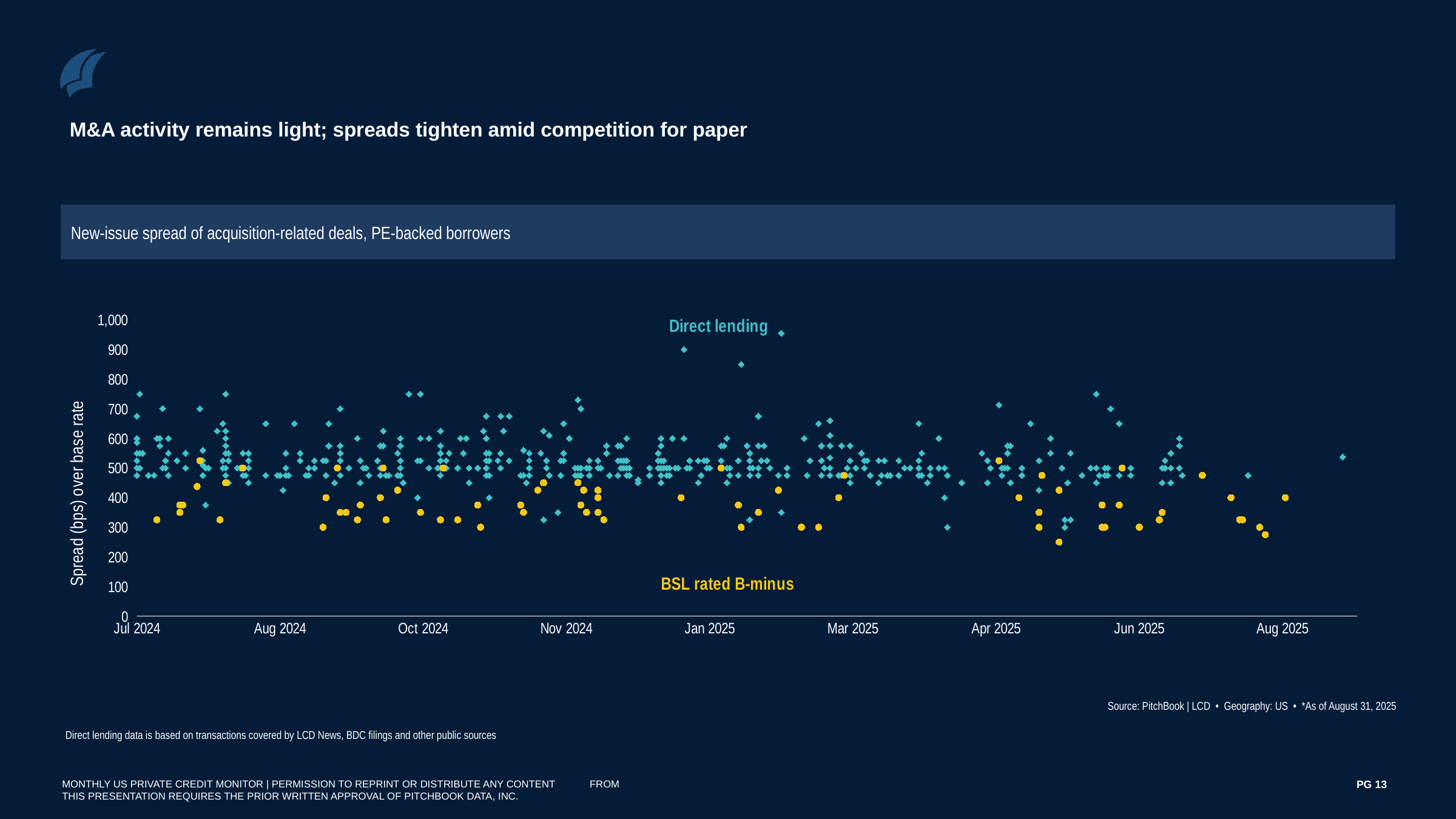
What is the label of the vertical axis? Spread (bps) over base rate How many data series are plotted on the chart? 2 Is the lowest BSL rated B-minus point on the chart greater or less than 300? less Is the highest Direct lending point on the chart greater or less than 900? greater What is the last month label on the horizontal axis? Aug 2025 Which series contains the single highest point on the chart? Direct lending What are the names of the two series plotted on the chart? Direct lending and BSL rated B-minus What kind of chart is shown on the slide? Scatter chart Is the highest BSL rated B-minus point on the chart greater or less than 600? less Which series generally shows higher spreads, Direct lending or BSL rated B-minus? Direct lending What is the highest value shown on the vertical axis? 1,000 What is the first month label on the horizontal axis? Jul 2024